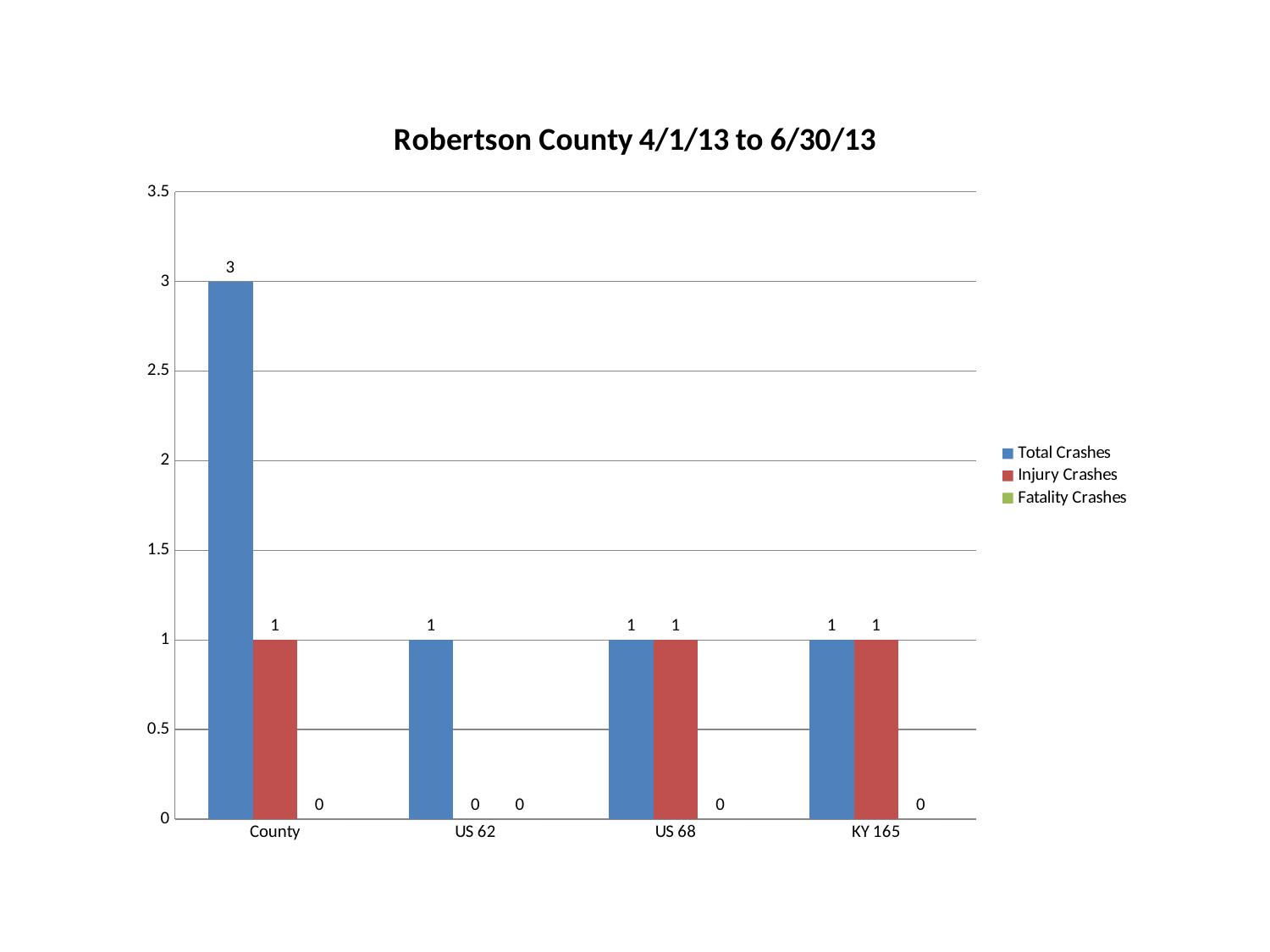
What is the value of Total Crashes for County? 3 What kind of chart is shown on the slide? Bar chart How many categories are shown on the x axis? 4 What is the title of the chart? Robertson County 4/1/13 to 6/30/13 What is the value of Fatality Crashes for US 68? 0 Which series is shown in red? Injury Crashes What is the value of Injury Crashes for US 62? 0 What is the value of Injury Crashes for KY 165? 1 How many series does the legend list? 3 Which is larger, Total Crashes for County or Total Crashes for US 68? Total Crashes for County What is the difference between Total Crashes and Injury Crashes for County? 2 Which category has the highest Total Crashes value? County